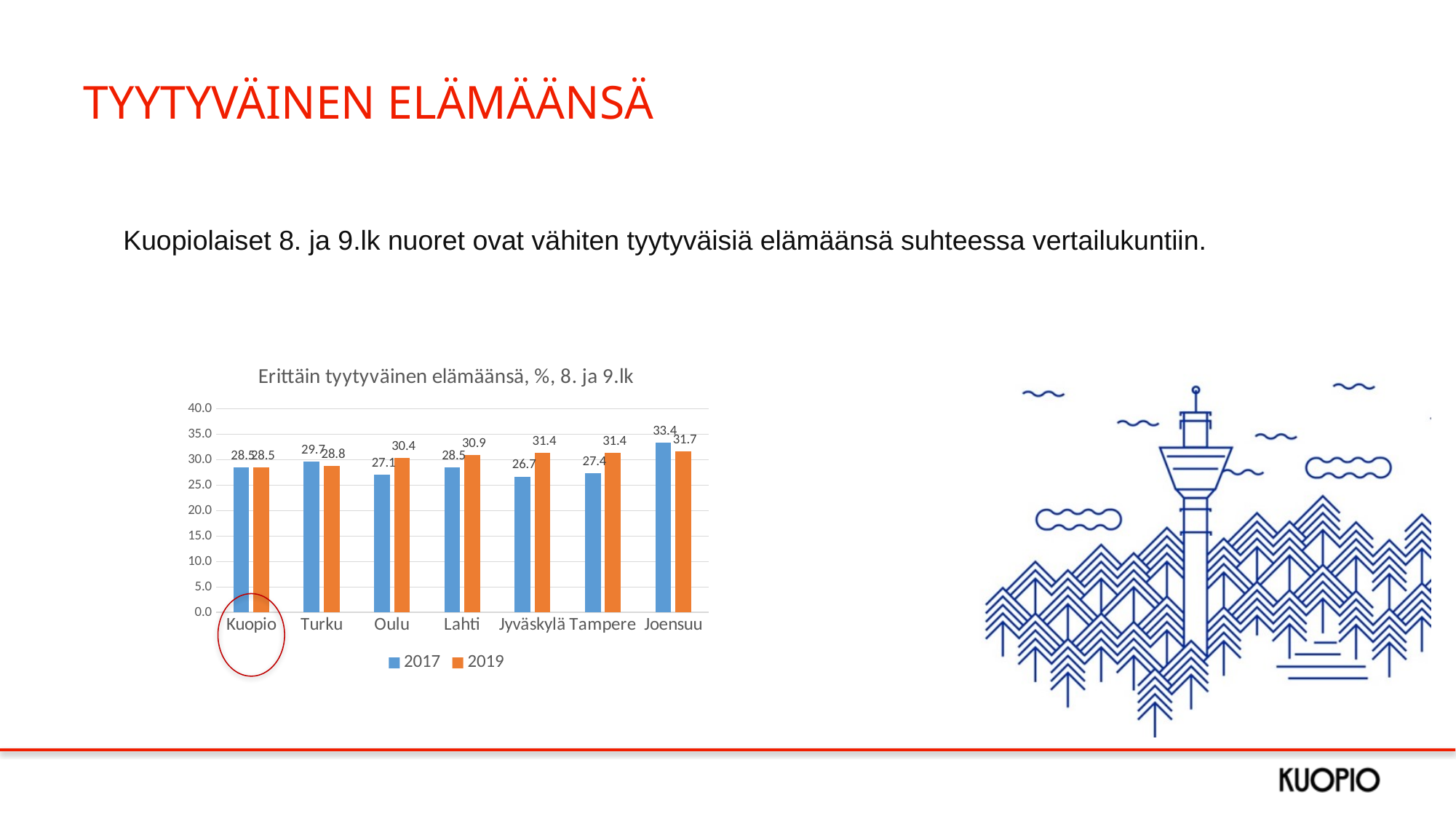
How many series does the legend list? 2 Which city has the lowest 2017 value? Jyväskylä How many cities are shown on the x axis? 7 Which is larger for Tampere, the 2017 value or the 2019 value? 2019 What is the 2019 value for Oulu? 30.4 Which city has the lowest 2019 value? Kuopio What is the 2019 value for Jyväskylä? 31.4 What is the 2017 value for Joensuu? 33.4 Which city has the highest 2017 value? Joensuu What kind of chart is shown on the slide? Bar chart What is the difference between the 2017 and 2019 values for Joensuu? 1.7 What is the difference between the 2019 and 2017 values for Oulu? 3.3